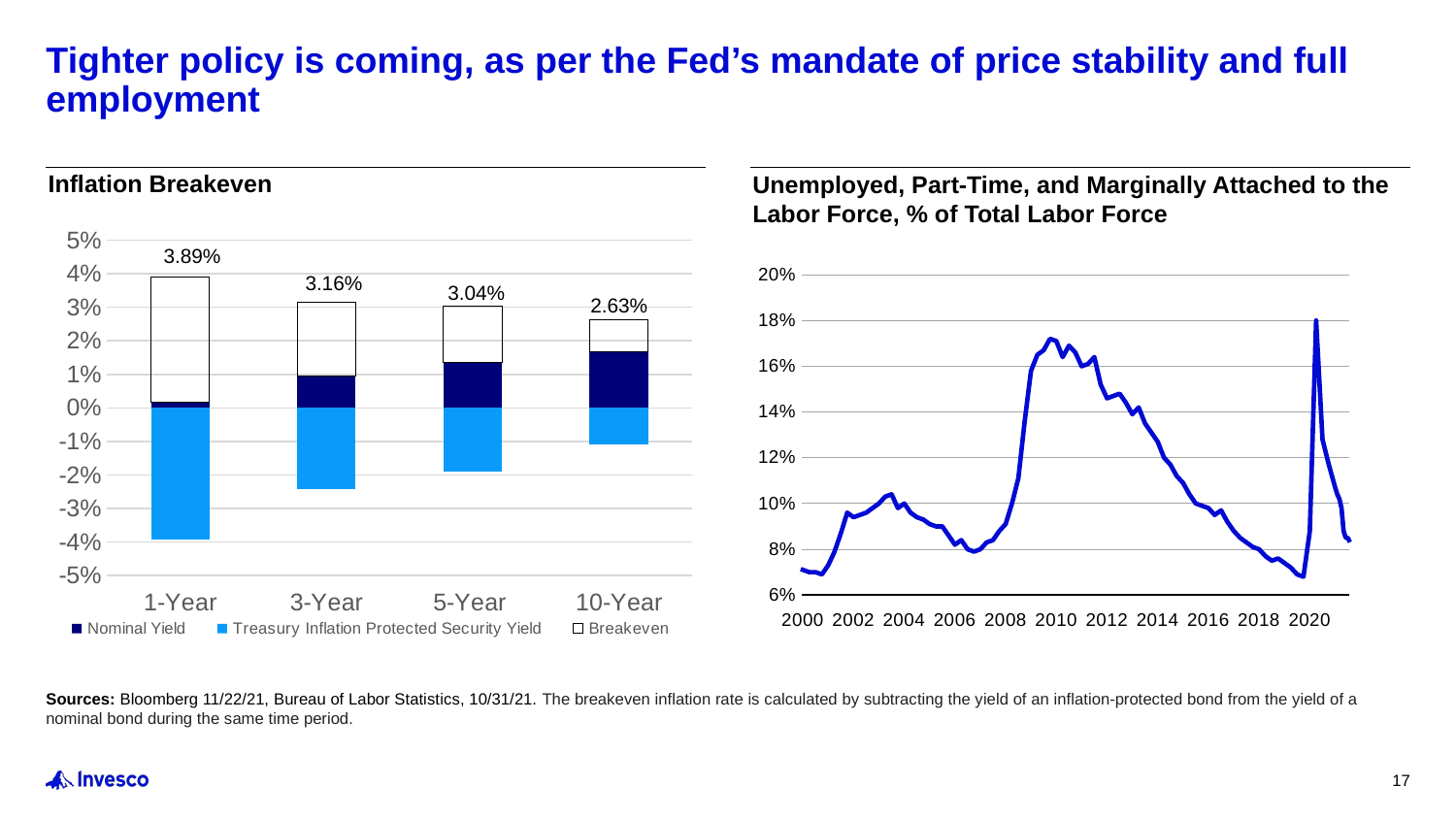
On the Inflation Breakeven chart, do the labeled values rise or fall from 1-Year to 10-Year? Fall How many maturity categories are shown on the Inflation Breakeven chart? 4 On the Inflation Breakeven chart, what is the labeled value for 1-Year? 3.89% What kind of chart is the Inflation Breakeven chart? Bar chart On the Inflation Breakeven chart, which has the larger labeled value, 3-Year or 5-Year? 3-Year On the Inflation Breakeven chart, what is the labeled value for 10-Year? 2.63% What kind of chart is the chart on the right, titled 'Unemployed, Part-Time, and Marginally Attached to the Labor Force, % of Total Labor Force'? Line chart On the Inflation Breakeven chart, what is the difference between the labeled values for 1-Year and 10-Year? 1.26% On the right-hand labor force chart, is the peak value reached around 2020 greater or less than 16%? greater How many series does the legend of the Inflation Breakeven chart list? 3 On the Inflation Breakeven chart, which maturity has the lowest labeled value? 10-Year On the Inflation Breakeven chart, which maturity has the highest labeled value? 1-Year